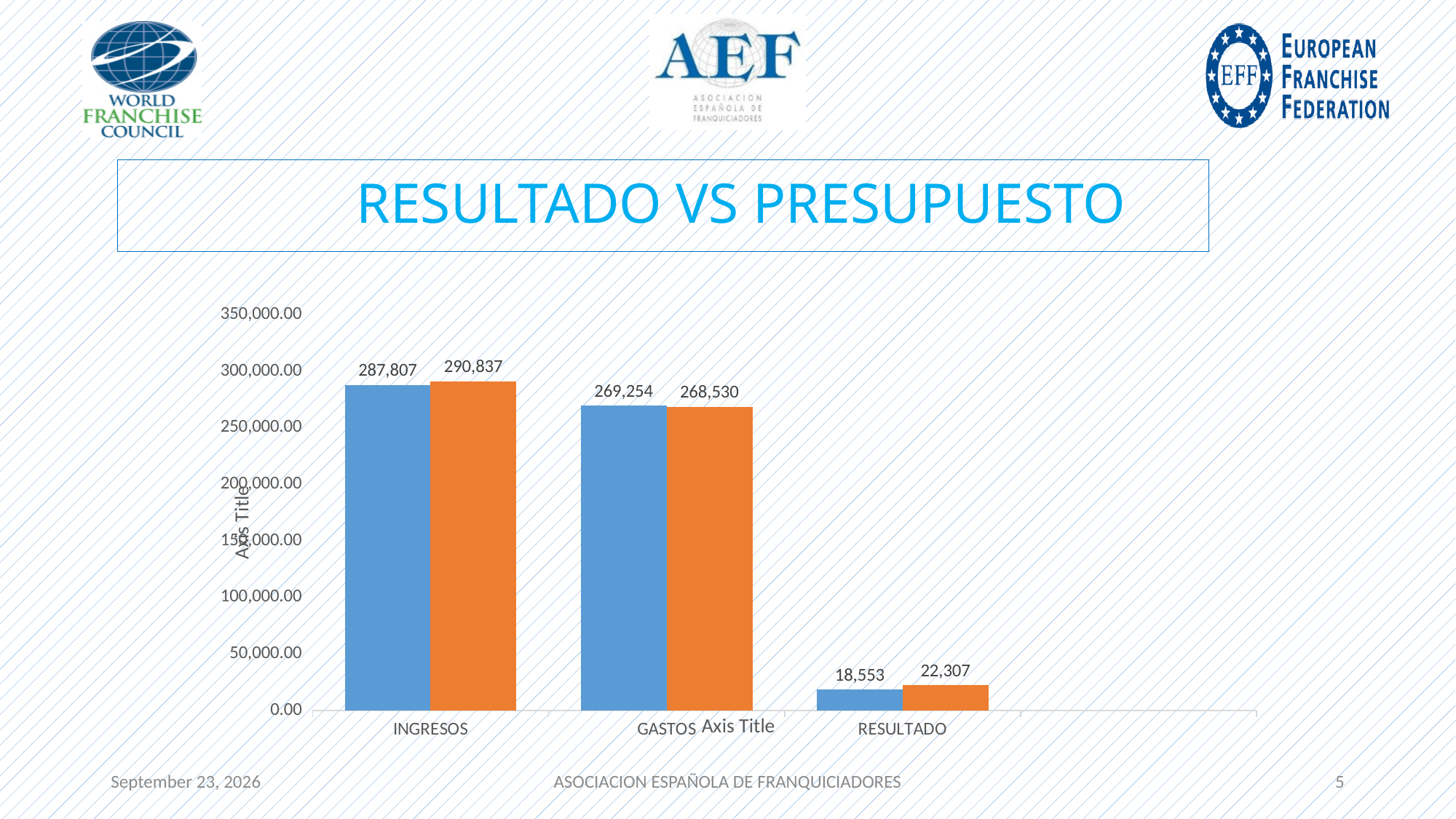
What is the value of the orange bar for INGRESOS? 290,837 Which category has the lowest values in the chart? RESULTADO What is the value of the blue bar for INGRESOS? 287,807 How many categories are shown on the x axis? 3 What is the value of the blue bar for GASTOS? 269,254 What is the difference between the orange and blue bars for INGRESOS? 3,030 Is the blue bar for RESULTADO greater or less than 50,000.00? less What type of chart is shown on the slide? bar chart For GASTOS, which bar is larger, the blue or the orange? blue Which category has the highest values in the chart? INGRESOS What is the difference between the orange and blue bars for RESULTADO? 3,754 What is the value of the orange bar for RESULTADO? 22,307